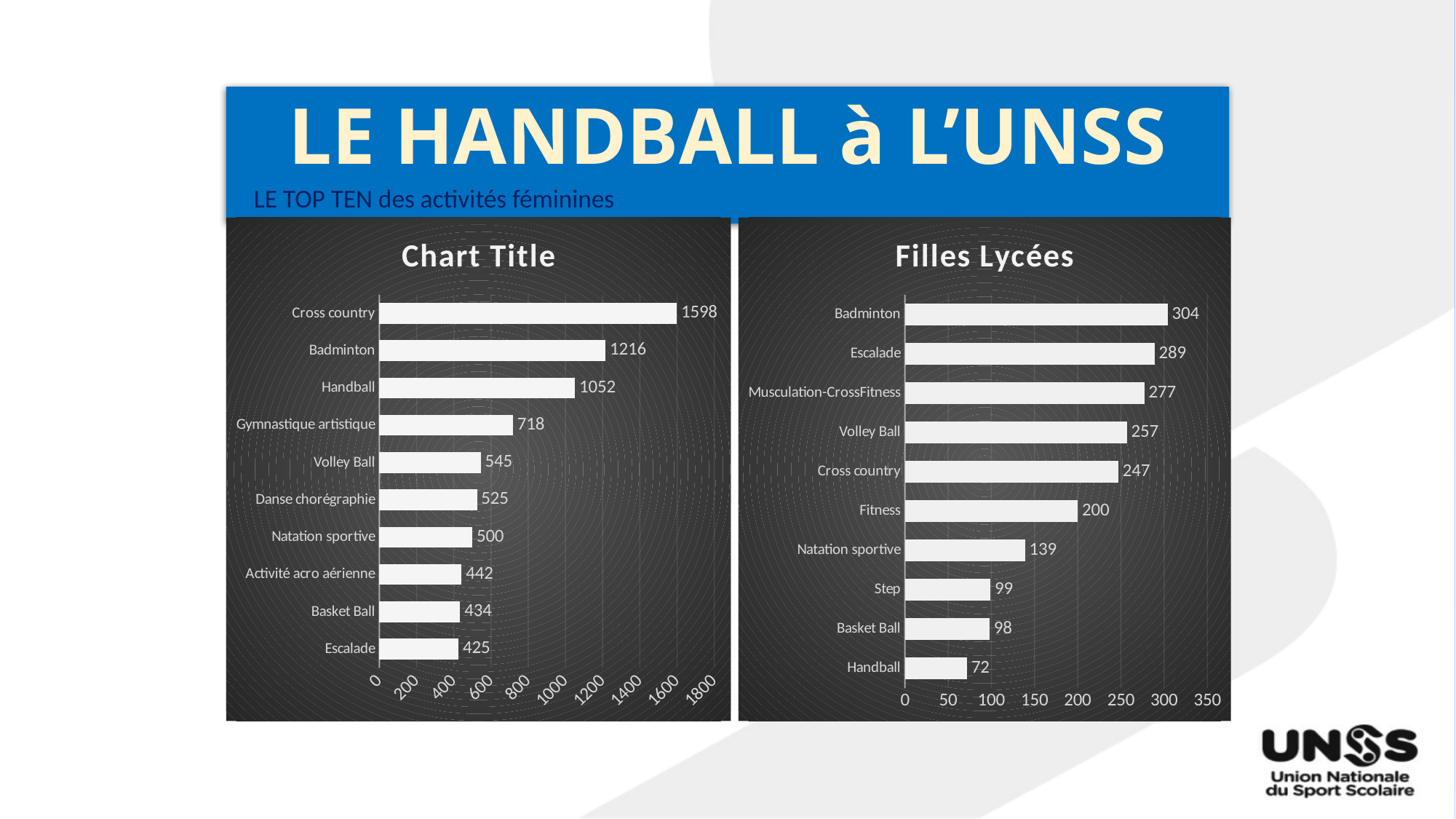
In the right chart titled "Filles Lycées", which is larger, the value for Escalade or the value for Volley Ball? Escalade In the left chart titled "Chart Title", how many categories are shown? 10 In the left chart titled "Chart Title", what is the difference between the values for Cross country and Badminton? 382 In the left chart titled "Chart Title", what is the value for Handball? 1052 In the right chart titled "Filles Lycées", what is the value for Handball? 72 In the left chart titled "Chart Title", what is the value for Gymnastique artistique? 718 What kind of chart is the right chart titled "Filles Lycées"? Bar chart In the left chart titled "Chart Title", which category has the highest value? Cross country In the right chart titled "Filles Lycées", what is the difference between the values for Badminton and Fitness? 104 In the left chart titled "Chart Title", which category has the lowest value? Escalade In the right chart titled "Filles Lycées", which category has the highest value? Badminton In the right chart titled "Filles Lycées", which category has the lowest value? Handball